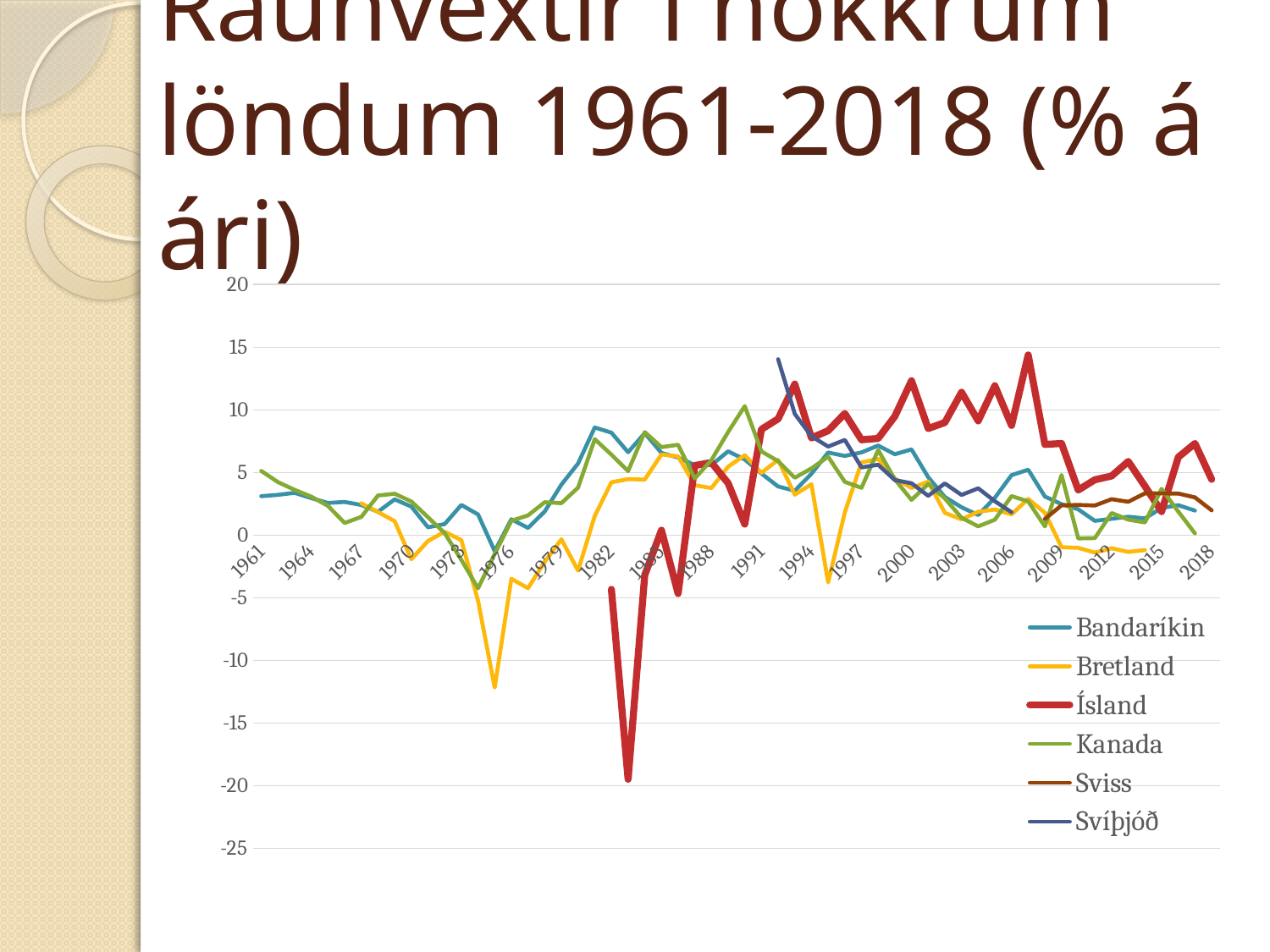
Around 2000, which series has the larger value, Ísland or Bretland? Ísland Is the lowest value for Bretland (around 1975) greater or less than -10? less Which series is drawn in red in the legend? Ísland Is the first plotted value for Svíþjóð (around 1992) greater or less than 10? greater Is the lowest value for Ísland (around 1983) greater or less than -15? less Which series reaches the lowest value anywhere on the chart? Ísland Around 1983, which series has the larger value, Ísland or Bandaríkin? Bandaríkin How many year labels are shown on the x axis? 20 How many series does the legend list? 6 What kind of chart is shown on the slide? line chart